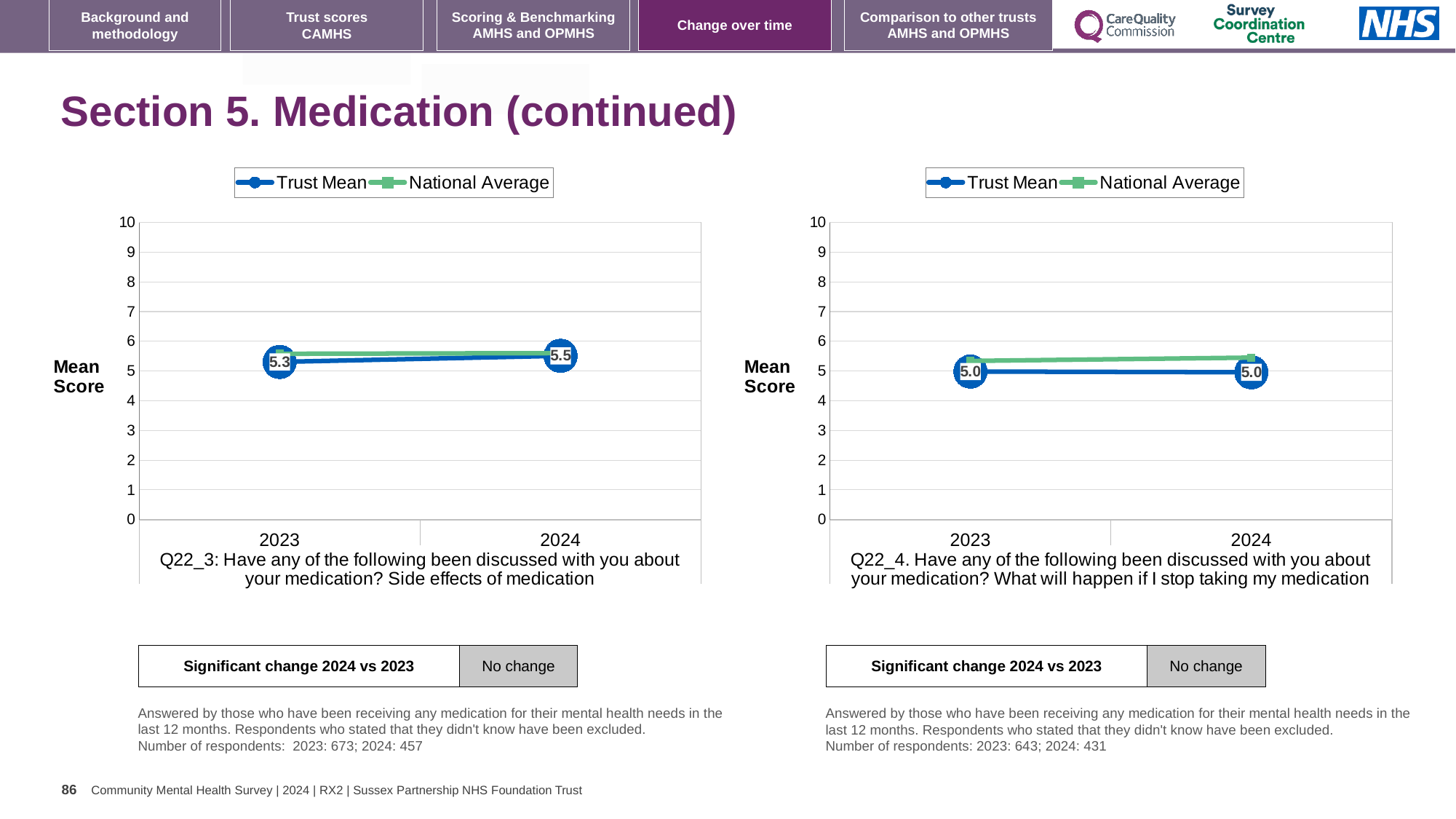
In the left chart (Q22_3), what is the Trust Mean for 2023? 5.3 How many years are plotted on the x axis of the left chart (Q22_3)? 2 In the left chart (Q22_3), which year has the higher Trust Mean, 2023 or 2024? 2024 In the left chart (Q22_3), by how much did the Trust Mean change from 2023 to 2024? 0.2 In the right chart (Q22_4), what is the Trust Mean for 2024? 5.0 In the left chart (Q22_3), does the Trust Mean rise or fall from 2023 to 2024? rise In the left chart (Q22_3), is the National Average for 2024 greater or less than 5? greater In the left chart (Q22_3), what is the Trust Mean for 2024? 5.5 What kind of chart is the right chart (Q22_4)? line chart In the right chart (Q22_4), does the Trust Mean rise, fall or stay the same from 2023 to 2024? stay the same In the right chart (Q22_4), what is the Trust Mean for 2023? 5.0 How many series does the legend of the right chart (Q22_4) list? 2